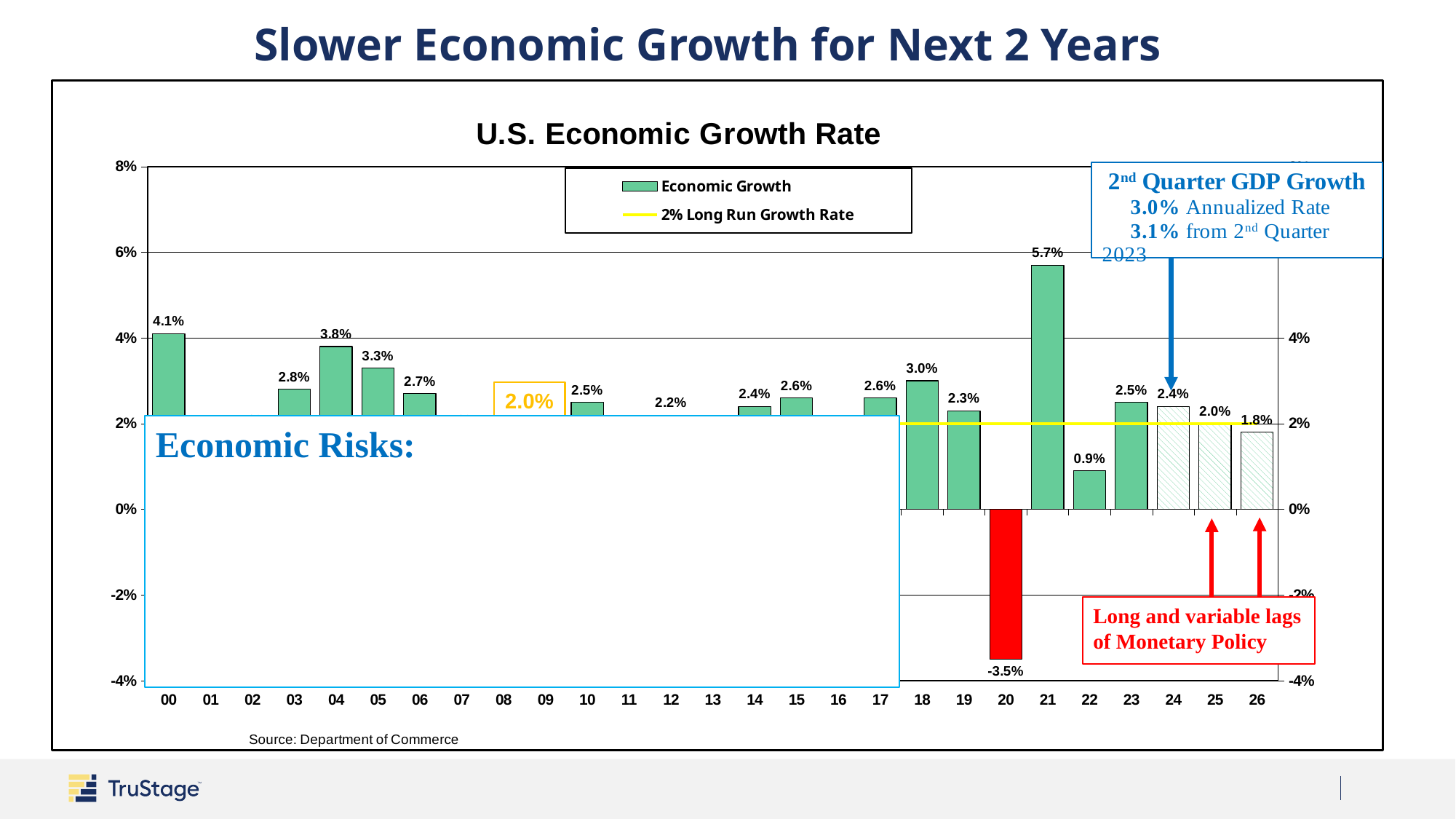
What is the economic growth rate shown for 21? 5.7% How many entries does the chart legend list? 2 Which year has a higher economic growth rate, 04 or 05? 04 Which year has the highest economic growth rate? 21 Which year has the lowest economic growth rate? 20 What is the economic growth rate shown for 20? -3.5% What is the economic growth rate shown for 26? 1.8% What is the title of the chart? U.S. Economic Growth Rate What is the difference between the economic growth rate for 21 and for 22? 4.8% What type of chart is used to show the economic growth rate? bar chart Do the economic growth rates rise or fall from 24 to 26? fall What is the economic growth rate shown for 00? 4.1%